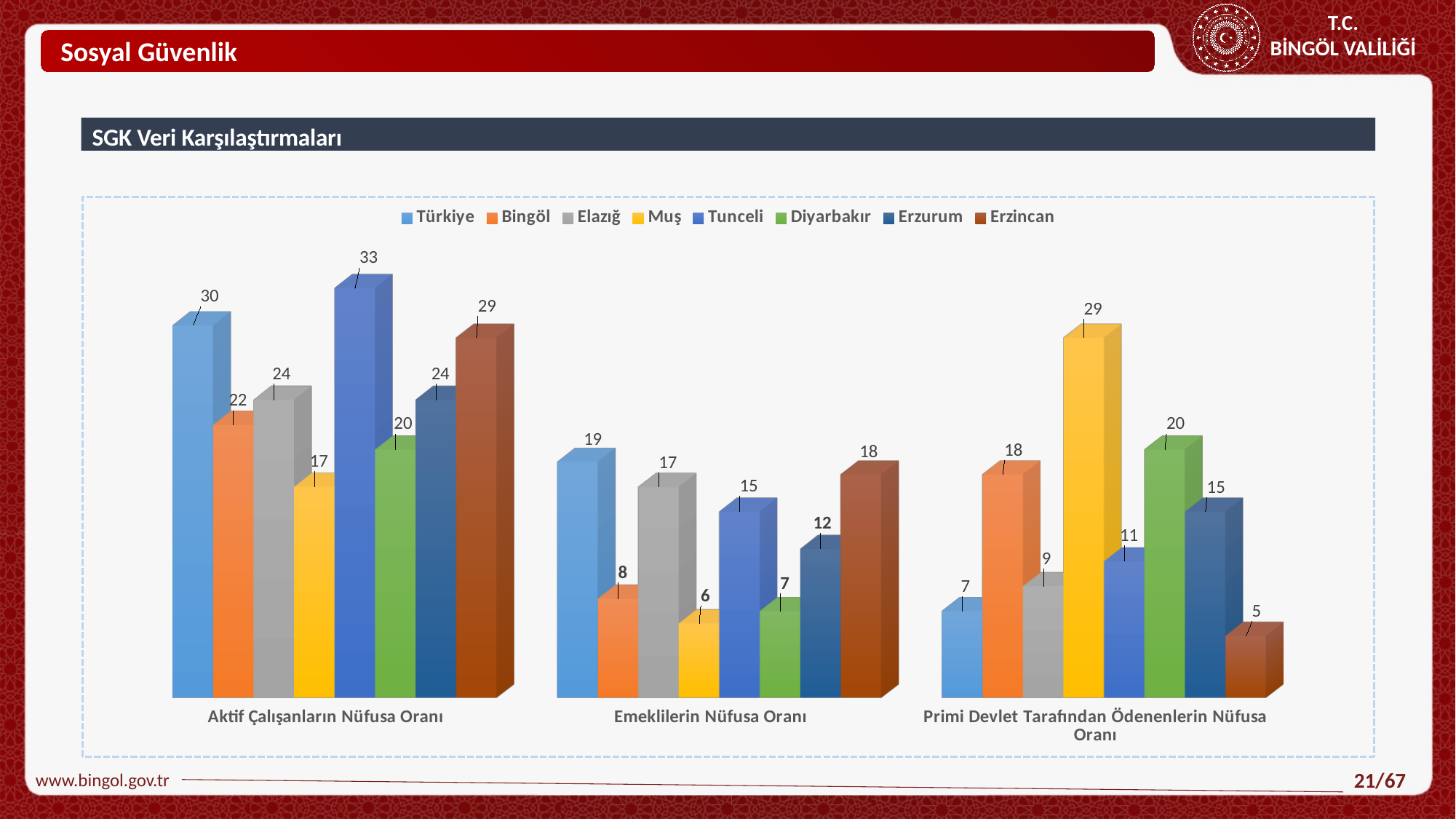
What kind of chart is shown on the slide? Bar chart In the Aktif Çalışanların Nüfusa Oranı category, which is larger: the value for Erzincan or the value for Elazığ? Erzincan What is the difference between the Muş and Diyarbakır values in the Primi Devlet Tarafından Ödenenlerin Nüfusa Oranı category? 9 What is the value for Erzurum in the Emeklilerin Nüfusa Oranı category? 12 What is the difference between the Türkiye and Bingöl values in the Emeklilerin Nüfusa Oranı category? 11 Which series has the highest value in the Aktif Çalışanların Nüfusa Oranı category? Tunceli Which series has the lowest value in the Primi Devlet Tarafından Ödenenlerin Nüfusa Oranı category? Erzincan Which series has the lowest value in the Emeklilerin Nüfusa Oranı category? Muş How many categories are shown on the x axis? 3 What is the value for Muş in the Primi Devlet Tarafından Ödenenlerin Nüfusa Oranı category? 29 What is the value for Bingöl in the Aktif Çalışanların Nüfusa Oranı category? 22 How many series does the legend list? 8